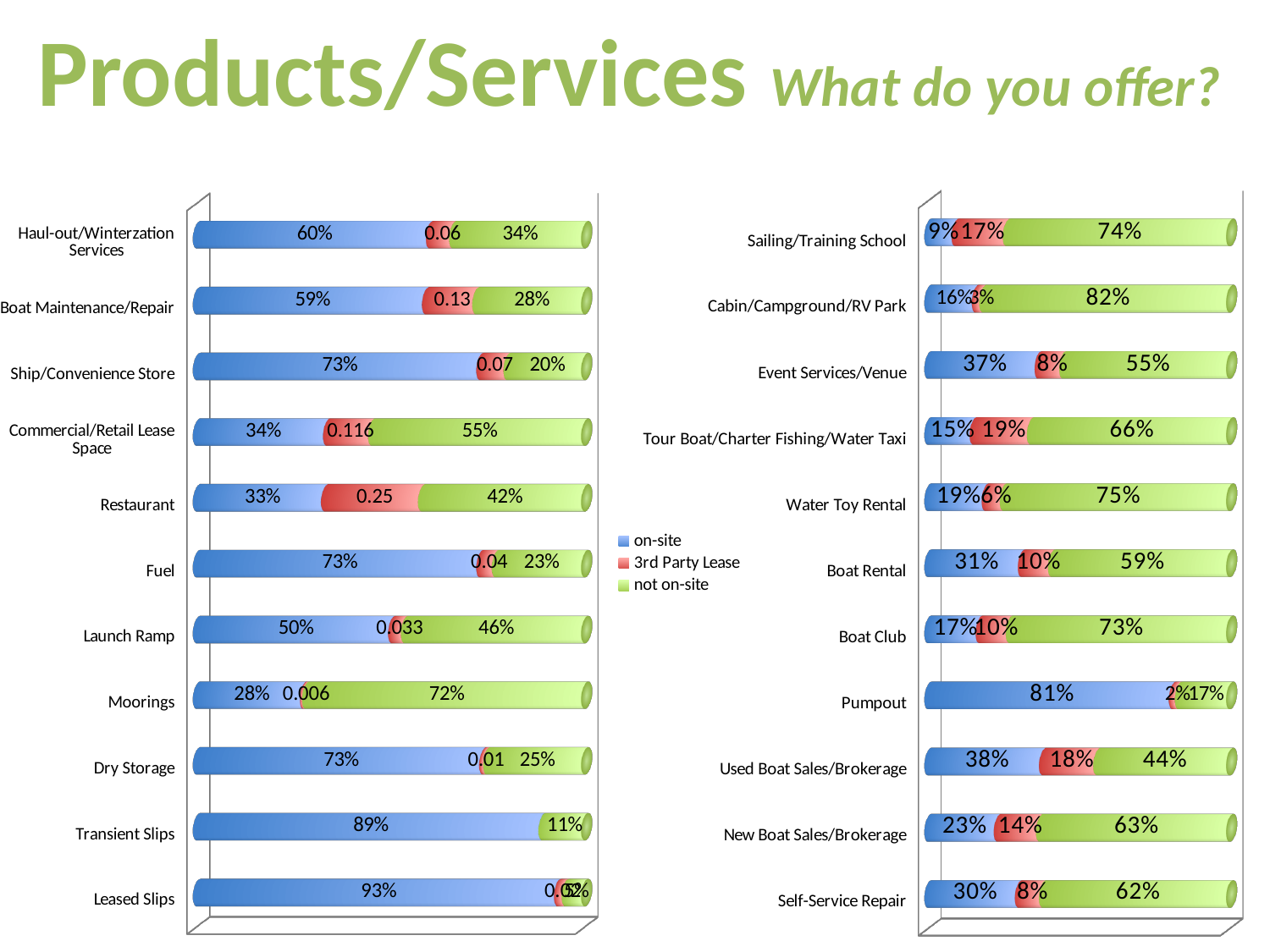
In the left chart, what is the on-site value for Transient Slips? 89% In the left chart, what is the not on-site value for Restaurant? 42% What kind of chart is the left chart? Stacked bar chart How many categories are shown in the left chart? 11 In the right chart, what is the not on-site value for Sailing/Training School? 74% In the right chart, what is the difference between the not on-site values for Self-Service Repair and Used Boat Sales/Brokerage? 18 percentage points In the right chart, what is the 3rd Party Lease value for Used Boat Sales/Brokerage? 18% In the right chart, which has the larger on-site value: Event Services/Venue or Boat Rental? Event Services/Venue In the right chart, which category has the highest not on-site value? Cabin/Campground/RV Park In the left chart, which category has the highest on-site value? Leased Slips In the right chart, what is the on-site value for Pumpout? 81% How many series does the legend list? 3